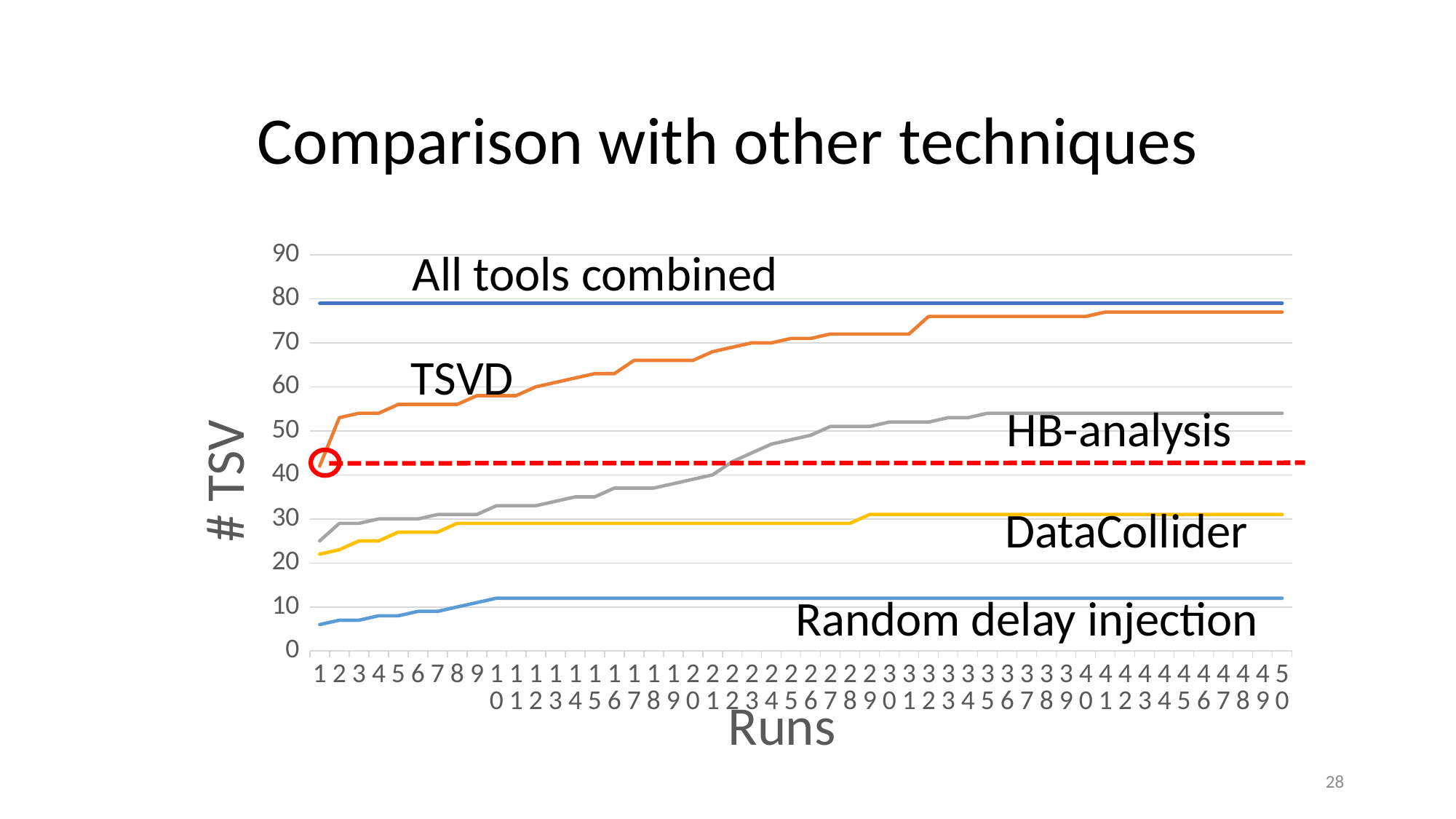
Which technique has the highest line on the chart? All tools combined What is the label of the vertical axis? # TSV What kind of chart is shown on the slide? line chart Is the value for All tools combined greater or less than 70? greater At run 50, which is larger, TSVD or HB-analysis? TSVD Does the TSVD line rise or fall as the number of runs increases? rise Does the HB-analysis line rise or fall as the number of runs increases? rise How many runs are shown along the x axis? 50 Is the value for Random delay injection at run 50 greater or less than 20? less Which technique has the lowest line on the chart? Random delay injection What is the title of the slide? Comparison with other techniques Is the value for DataCollider at run 50 greater or less than 40? less